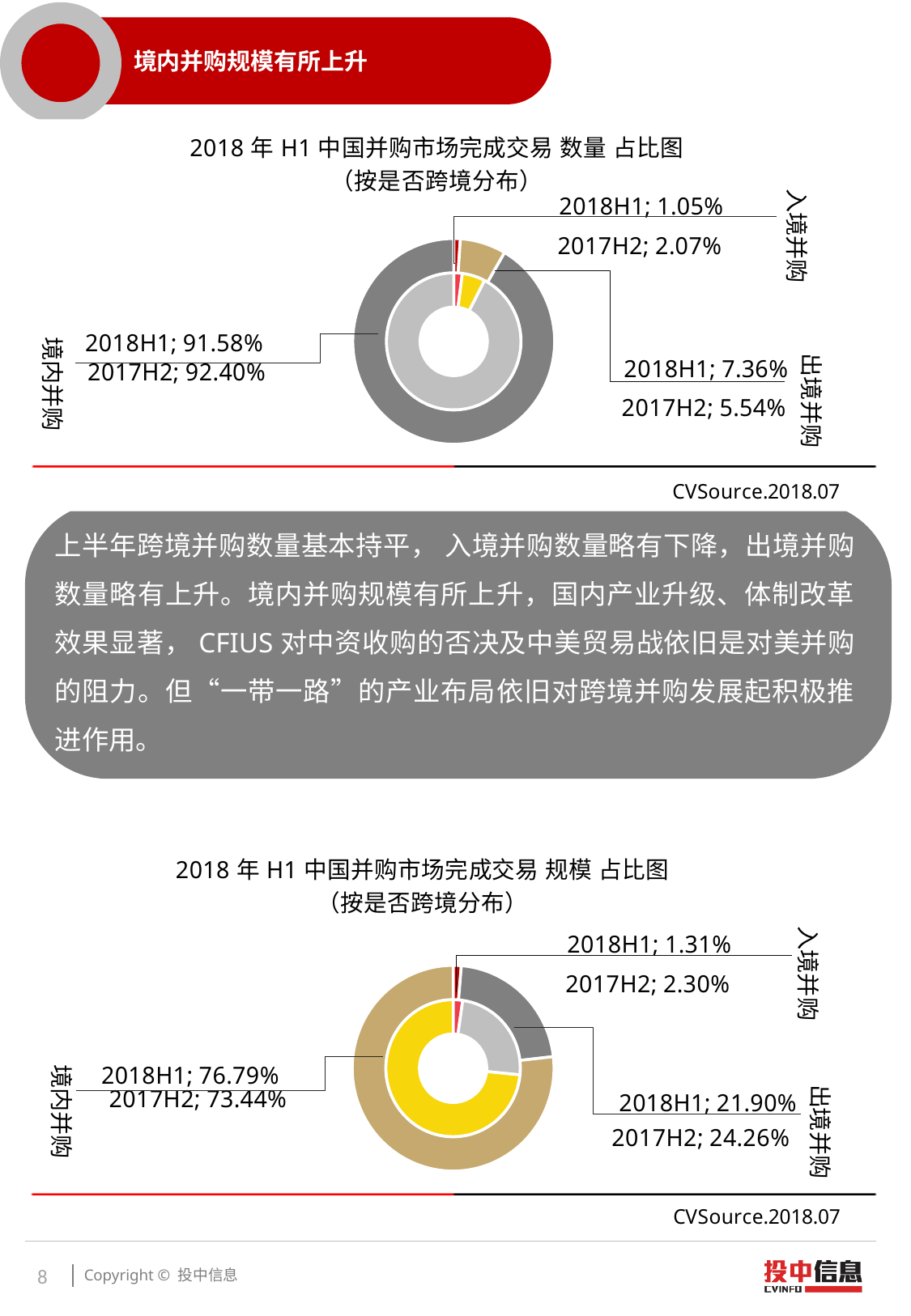
In the bottom chart (2018年H1中国并购市场完成交易规模占比图), what is the 2018H1 share for 出境并购? 21.90% In the top chart (数量占比图), what is the 2018H1 share for 入境并购? 1.05% In the bottom chart (规模占比图), what is the 2017H2 share for 境内并购? 73.44% In the top chart (数量占比图), what is the 2017H2 share for 出境并购? 5.54% In the top chart (数量占比图), which category has the largest 2018H1 share? 境内并购 In the bottom chart (规模占比图), is the 2018H1 share for 境内并购 larger or smaller than its 2017H2 share? larger What type of chart is used for the top chart (数量占比图)? Doughnut chart In the top chart (数量占比图), what is the difference between the 2018H1 and 2017H2 shares for 出境并购? 1.82% In the bottom chart (规模占比图), what is the difference between the 2017H2 and 2018H1 shares for 入境并购? 0.99% In the top chart (2018年H1中国并购市场完成交易数量占比图), what is the 2018H1 share for 境内并购? 91.58% In the top chart (数量占比图), which category has the smallest 2017H2 share? 入境并购 How many categories are shown in the bottom chart (规模占比图)? 3